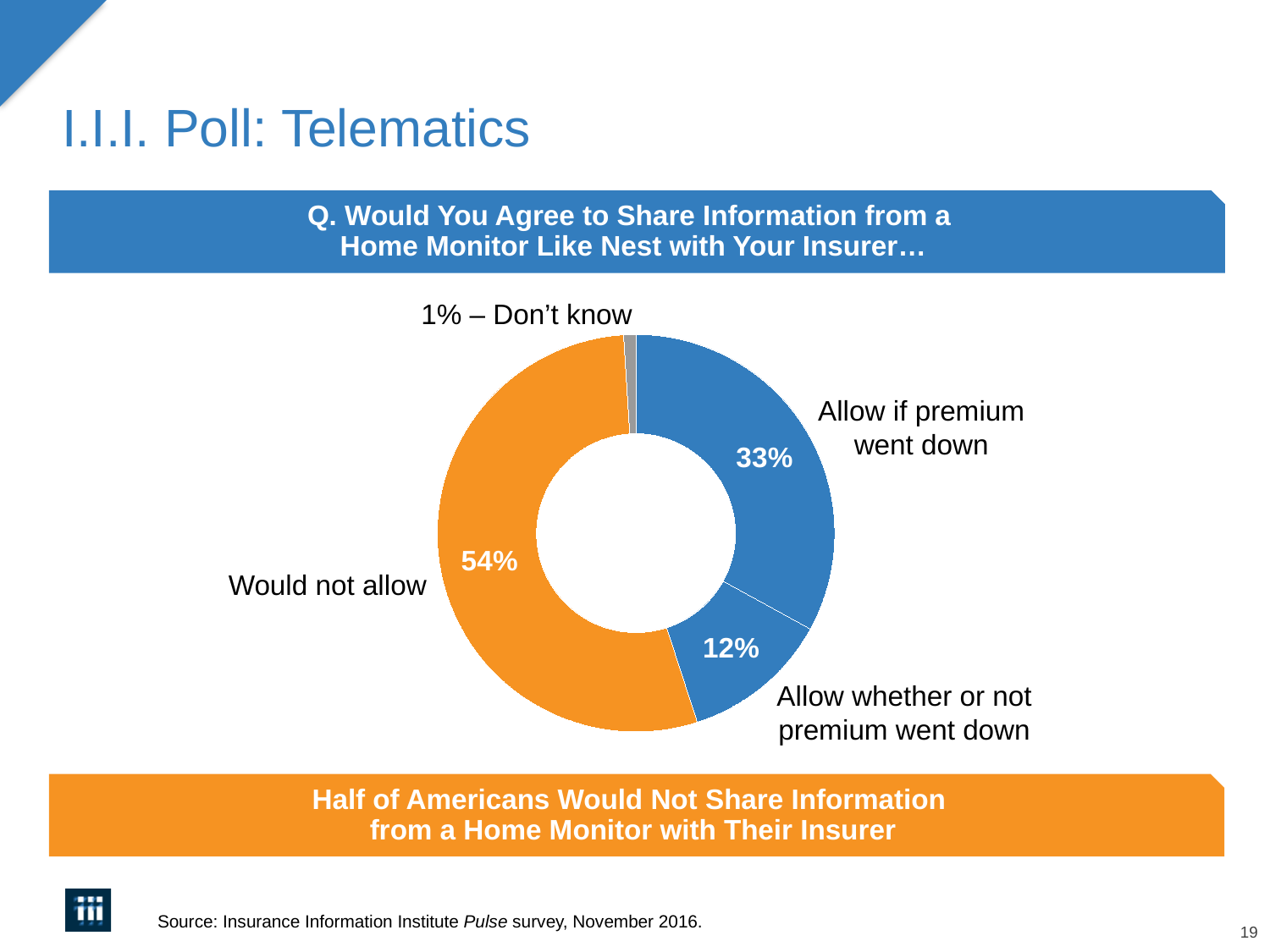
What share of respondents would allow sharing whether or not their premium went down? 12% Which response has the largest share of the chart? Would not allow What is the combined share of respondents who would allow sharing (either if premium went down or whether or not it went down)? 45% What share of respondents would not allow sharing information from a home monitor with their insurer? 54% Which is larger: the share for "Allow if premium went down" or the share for "Allow whether or not premium went down"? Allow if premium went down What is the difference in percentage points between "Would not allow" and "Allow if premium went down"? 21 percentage points How many response categories are shown in the chart? 4 What colour is the "Would not allow" segment of the chart? Orange What kind of chart is shown on the slide? Doughnut (pie) chart Which response has the smallest share of the chart? Don't know What share of respondents would allow sharing if their premium went down? 33% What share of respondents answered "Don't know"? 1%